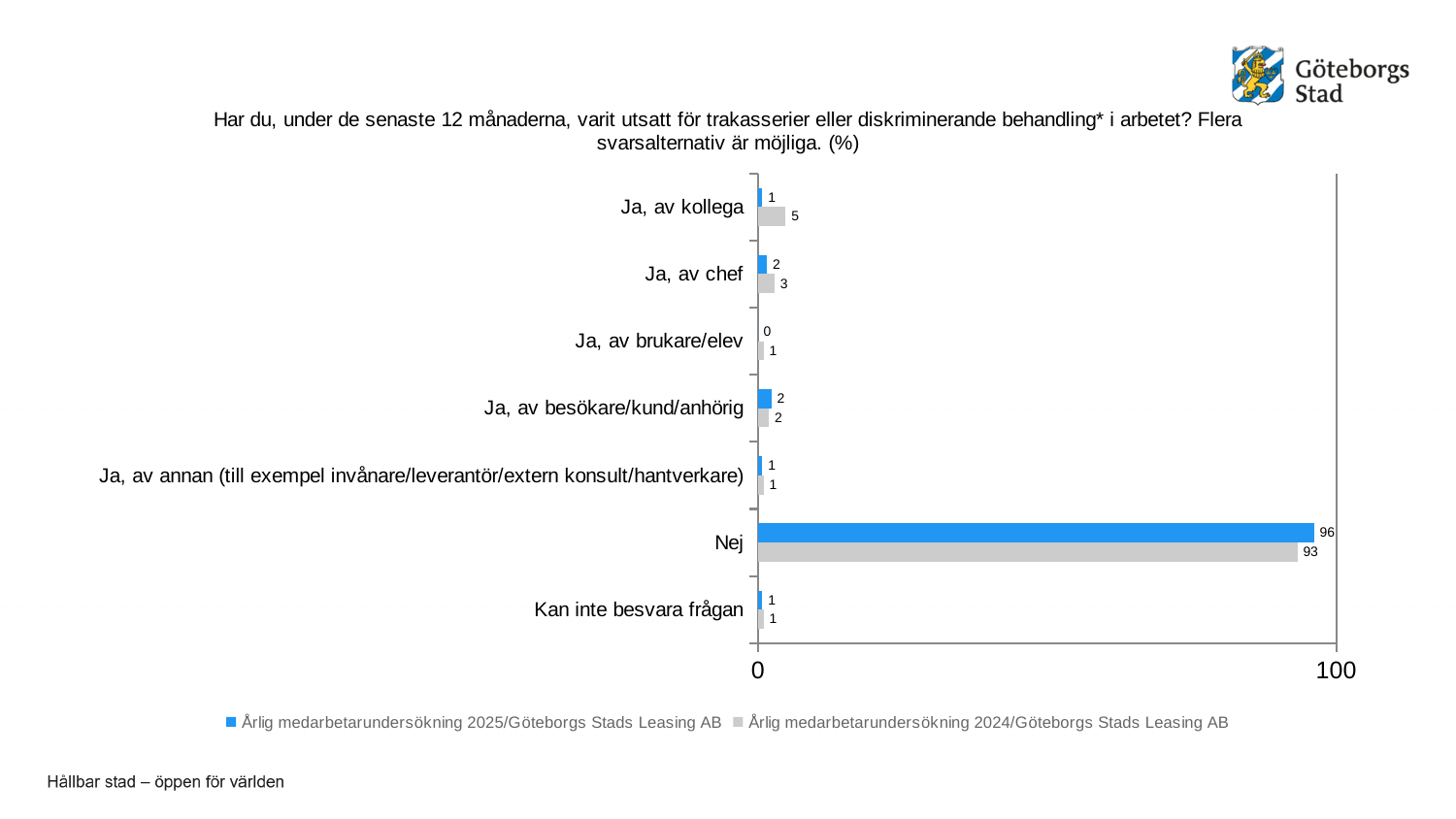
What is the difference between the 2025 and 2024 values for "Nej"? 3 For "Ja, av chef", which series has the larger value, 2025 or 2024? 2024 Which colour represents the 2025 series (Årlig medarbetarundersökning 2025/Göteborgs Stads Leasing AB)? Blue What is the value for "Ja, av brukare/elev" in the 2025 series? 0 How many series does the legend list? 2 What kind of chart is shown on the slide? Bar chart What is the difference between the 2024 and 2025 values for "Ja, av kollega"? 4 How many categories are shown on the chart? 7 What is the value for "Nej" in the 2025 series (Årlig medarbetarundersökning 2025/Göteborgs Stads Leasing AB)? 96 What is the value for "Ja, av chef" in the 2025 series? 2 What is the value for "Ja, av kollega" in the 2024 series (Årlig medarbetarundersökning 2024/Göteborgs Stads Leasing AB)? 5 Which category has the highest value in the 2025 series? Nej